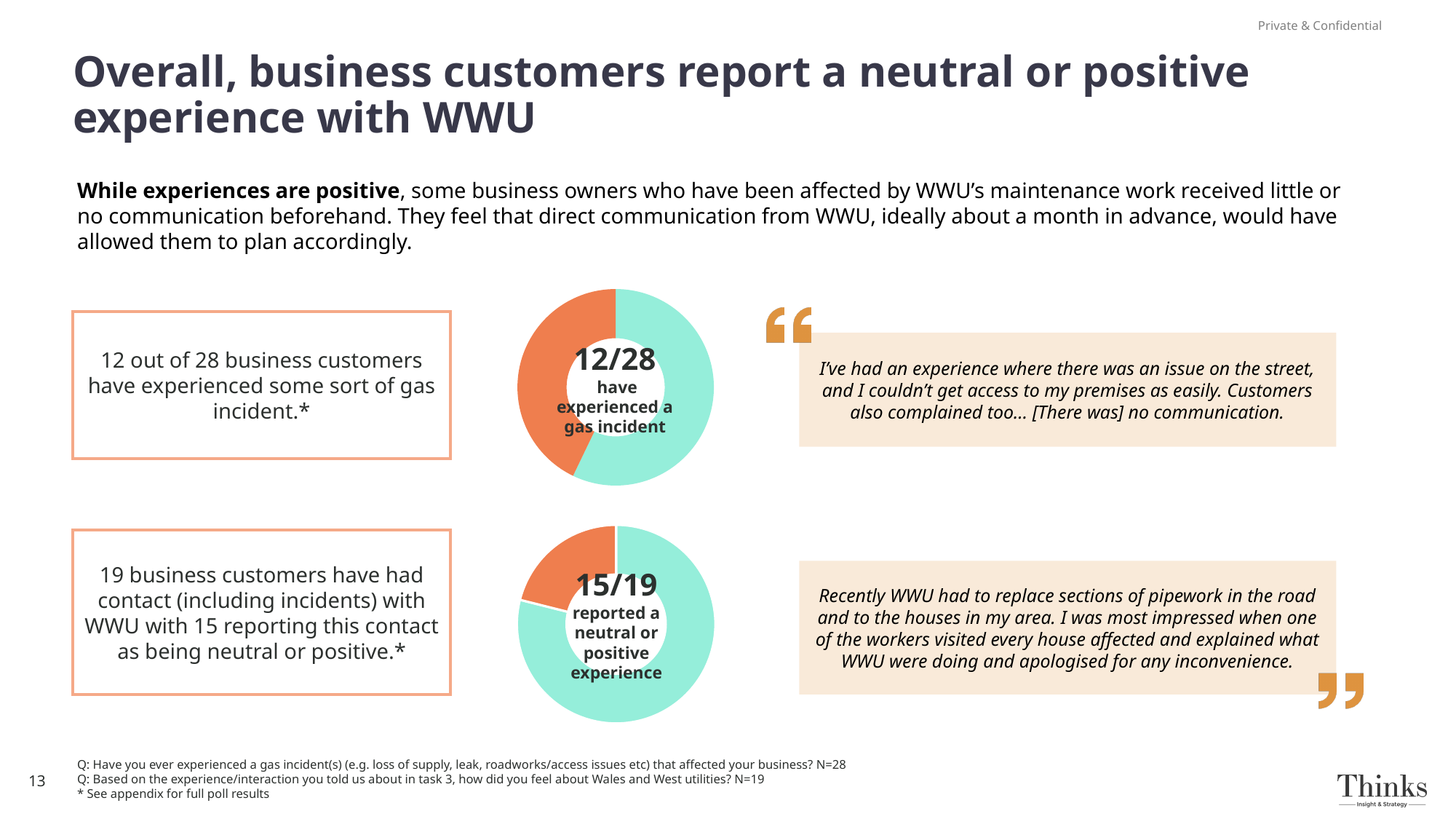
How many slices does each donut chart on the slide have? 2 In the bottom donut chart, how many business customers reported a neutral or positive experience? 15/19 What is the total number of respondents represented in the top donut chart? 28 In the bottom donut chart, how many of the 19 business customers did not report a neutral or positive experience? 4 In the top donut chart, what colour is the slice representing customers who have experienced a gas incident? Orange In the bottom donut chart, what colour is the slice representing the 15 customers who reported a neutral or positive experience? Teal What is the total number of respondents represented in the bottom donut chart? 19 In the top donut chart, how many of the 28 business customers have not experienced a gas incident? 16 In the bottom donut chart, which slice is larger: neutral or positive experience, or the remainder? Neutral or positive experience What kind of chart is used to show the 12/28 figure? Donut (pie) chart In the top donut chart, is the slice for customers who experienced a gas incident larger or smaller than the slice for those who did not? Smaller In the top donut chart, how many business customers have experienced a gas incident? 12/28